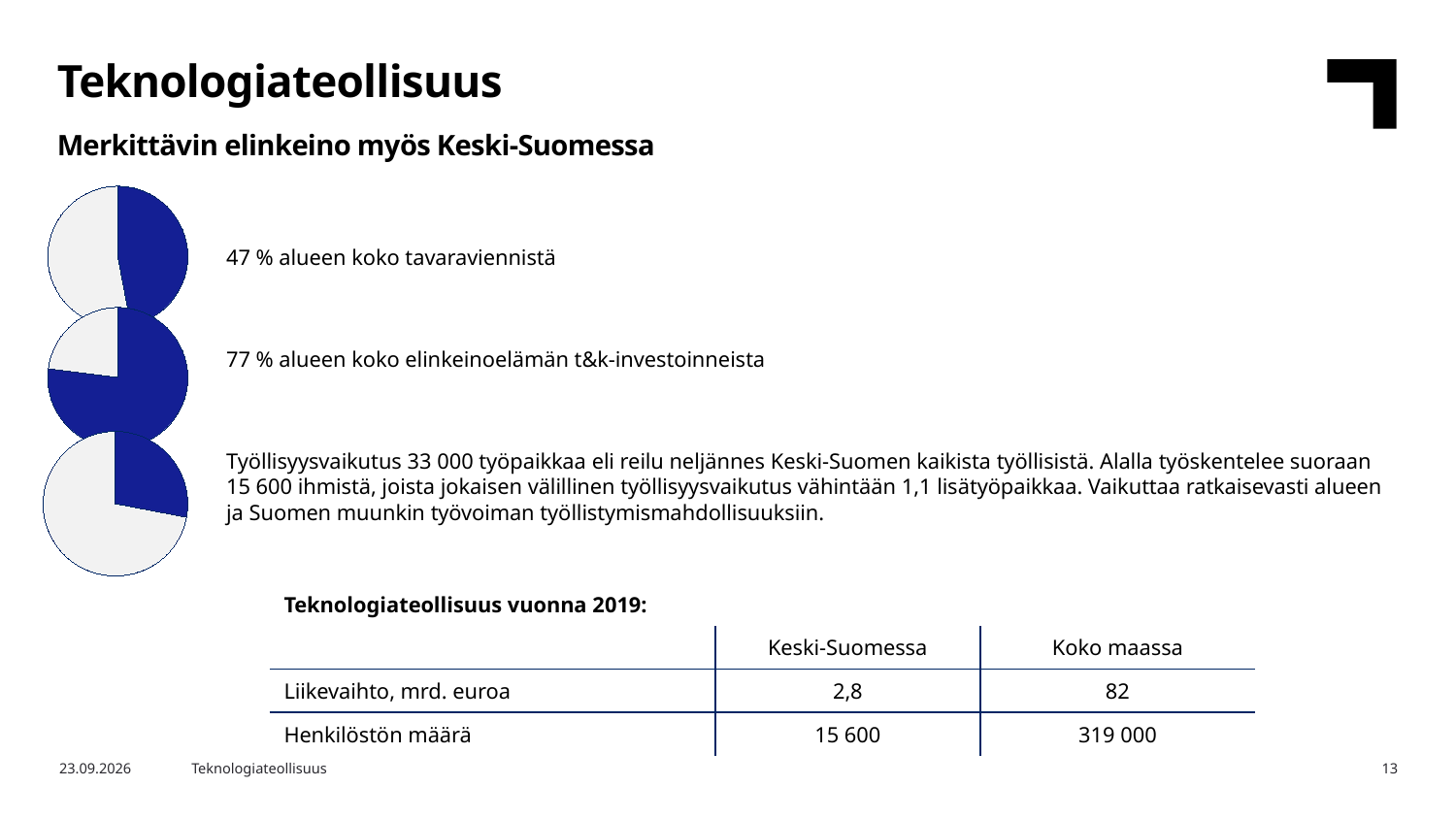
Is the blue slice larger in the top pie chart or in the middle pie chart? The middle pie chart What is the title of the slide containing the pie charts? Teknologiateollisuus In the top pie chart, what share of the region's total goods exports does the blue slice represent? 47 % Which of the three pie charts has the largest blue slice? The middle pie chart (77 %) Which of the three pie charts has the smallest blue slice? The bottom pie chart What kind of charts are shown on the left side of the slide? Pie charts What is the difference in percentage points between the blue shares of the middle and top pie charts? 30 percentage points In the middle pie chart, what share of the region's business R&D investments does the blue slice represent? 77 % How many pie charts are on the slide? 3 Is the blue slice in the bottom pie chart more or less than half of the pie? Less What colour is used for the highlighted slice in each pie chart? Blue